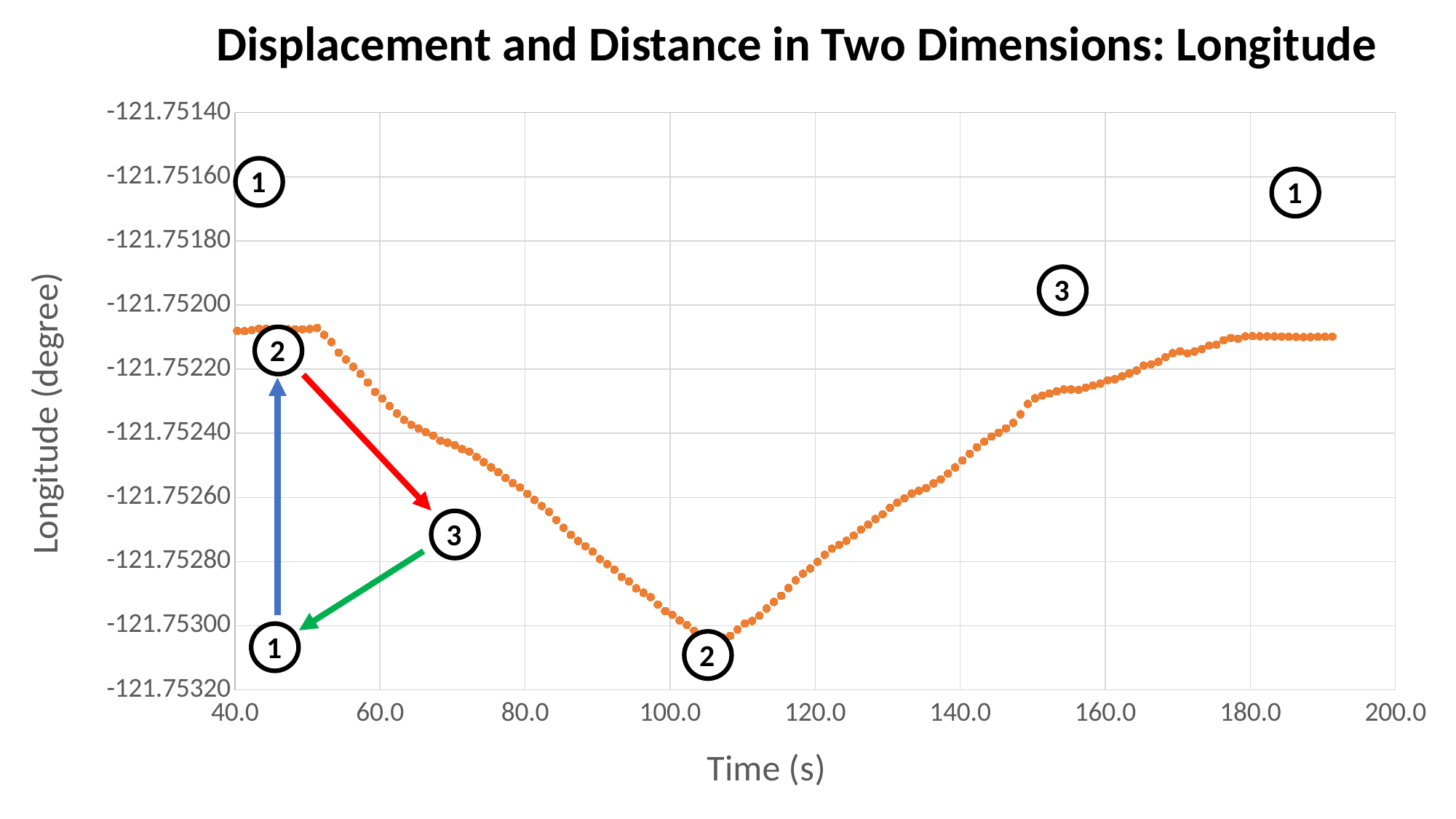
Is the longitude value at 140 s greater or less than -121.75260? greater Is the longitude value at 80 s greater or less than -121.75240? less What is the label of the x axis? Time (s) How many data series are plotted on the chart? 1 What kind of chart is shown on the slide? scatter chart Do the longitude values rise or fall between 60 s and 100 s? fall Is the longitude value at 100 s greater or less than -121.75280? less Which is larger, the longitude value at 100 s or at 180 s? 180 s Do the longitude values rise or fall between 120 s and 160 s? rise What is the title of the chart? Displacement and Distance in Two Dimensions: Longitude